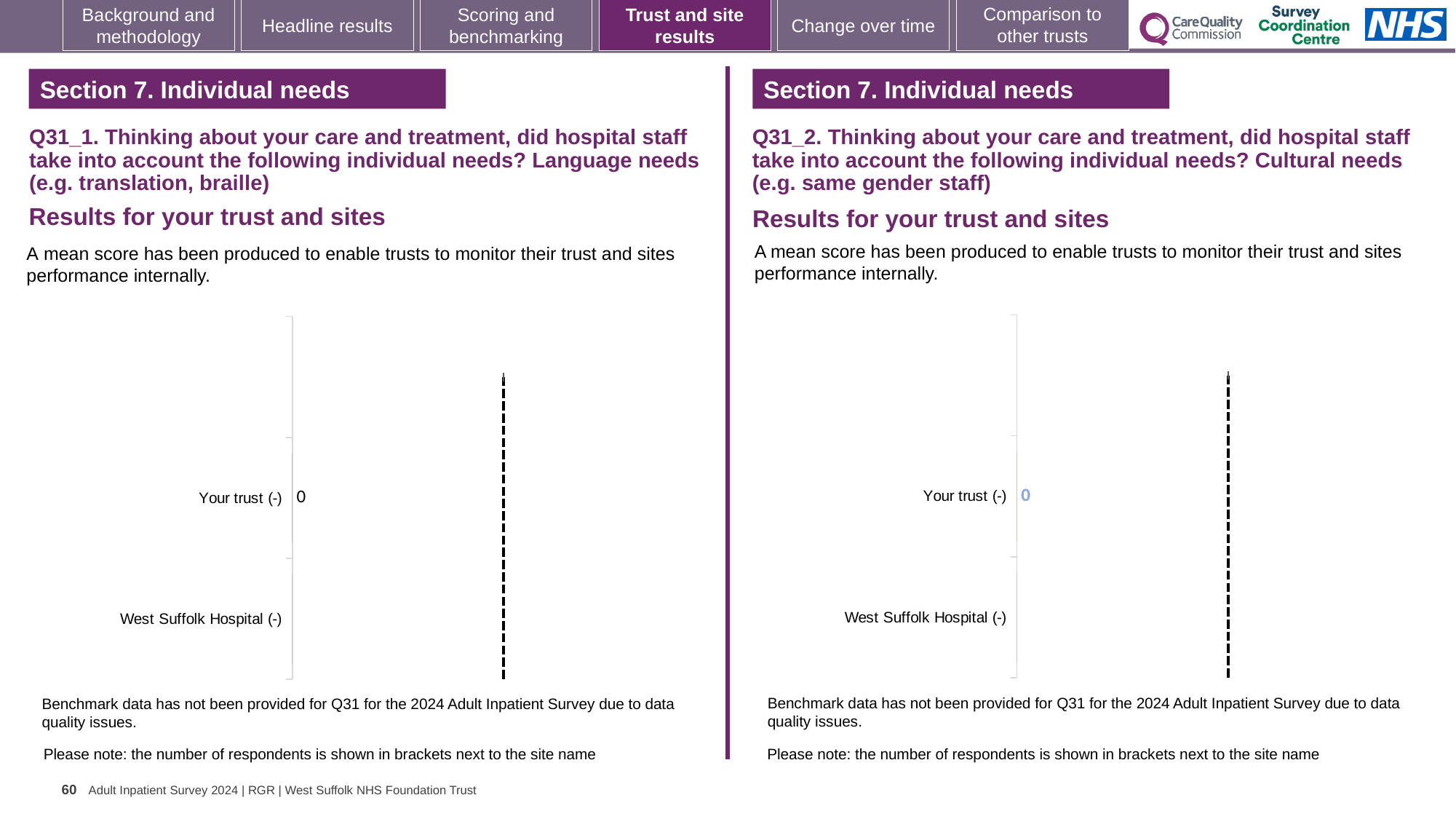
How many categories are listed on the vertical axis of the right chart (Q31_2, Cultural needs)? 2 How many charts are shown on the slide? 2 How many categories are listed on the vertical axis of the left chart (Q31_1, Language needs)? 2 In the right chart (Q31_2, Cultural needs), what value is shown for Your trust? 0 In the left chart (Q31_1, Language needs), what is the label of the category below Your trust? West Suffolk Hospital (-) In the right chart (Q31_2, Cultural needs), what is the label of the first category on the vertical axis? Your trust (-) In the left chart (Q31_1, Language needs), what value is shown for Your trust? 0